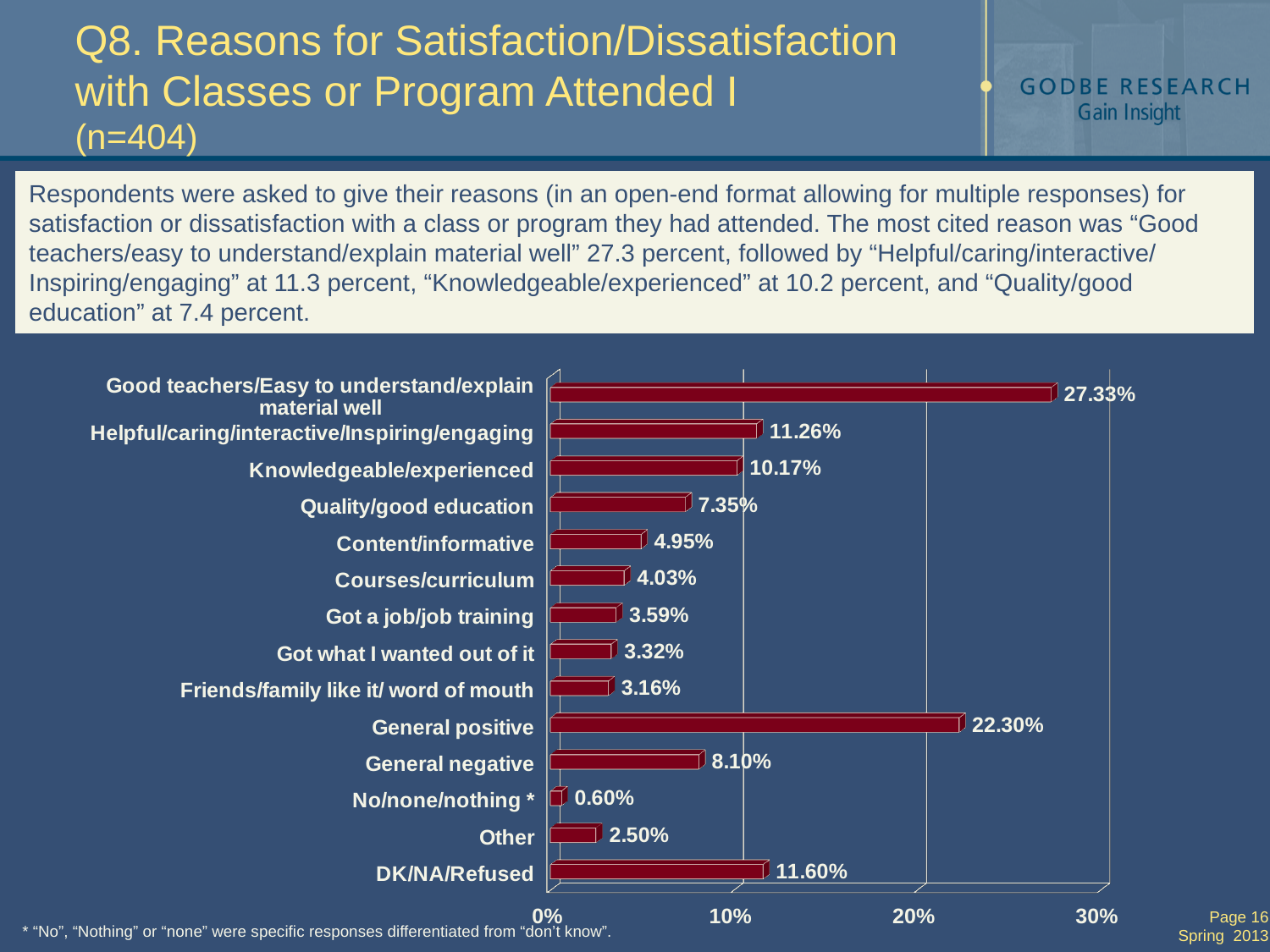
Is the value for "General negative" greater or less than 10%? less What is the value shown for "General positive"? 22.30% Which category has the lowest value in the chart? No/none/nothing * What is the difference between the values for "Good teachers/Easy to understand/explain material well" and "General positive"? 5.03% How many categories are shown in the chart? 14 What is the difference between the values for "Content/informative" and "Courses/curriculum"? 0.92% Which category has the highest value in the chart? Good teachers/Easy to understand/explain material well What is the highest value labelled on the horizontal axis of the chart? 30% What is the value shown for "DK/NA/Refused"? 11.60% What kind of chart is shown on the slide? Bar chart What percentage of respondents cited "Knowledgeable/experienced" as a reason? 10.17% Which is larger, the value for "Helpful/caring/interactive/Inspiring/engaging" or the value for "DK/NA/Refused"? DK/NA/Refused